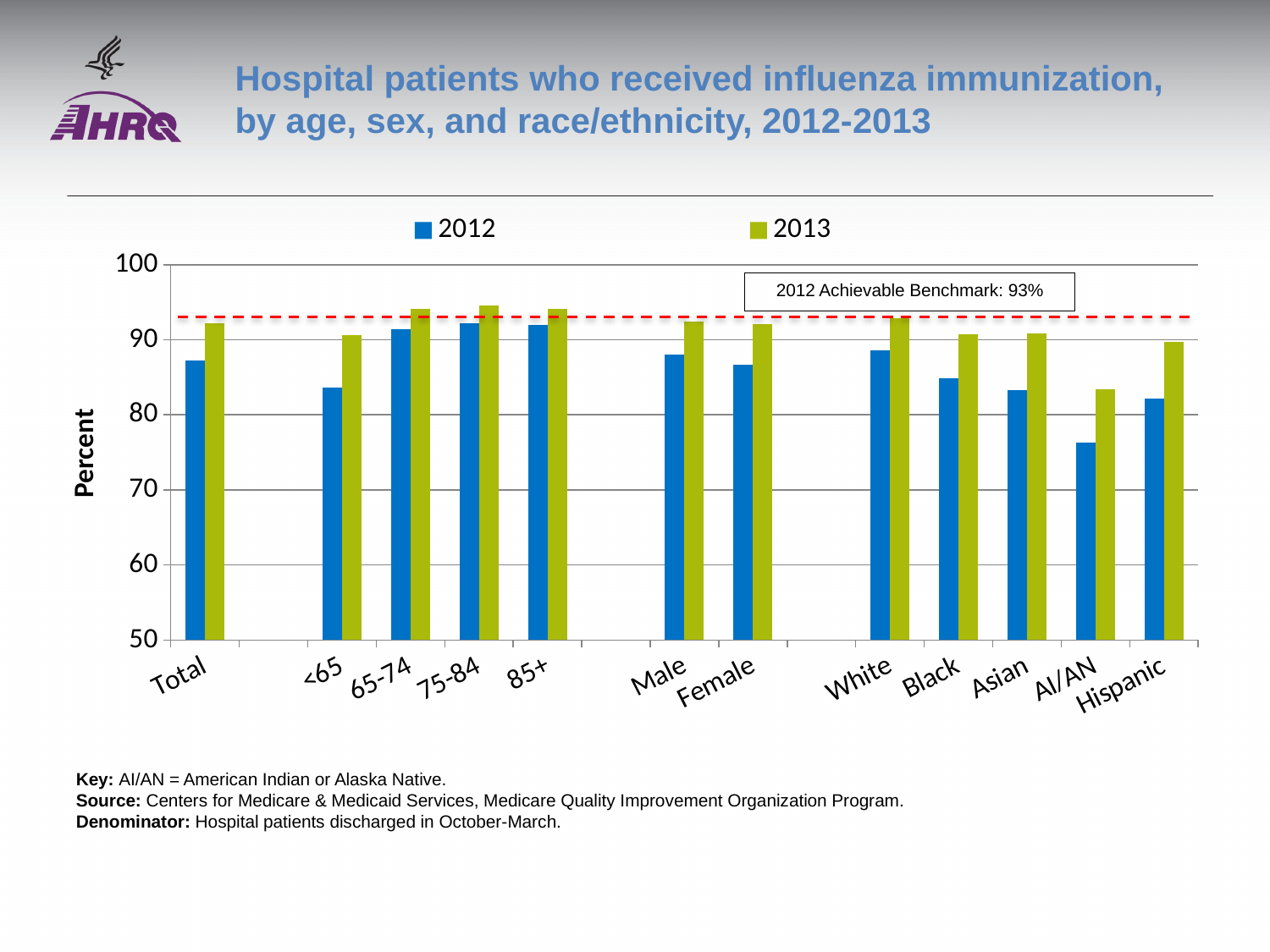
Is the 2012 value for Asian greater or less than 80? greater Which category has the lowest value for 2012? AI/AN How many series does the legend list? 2 What is the 2012 Achievable Benchmark shown on the chart? 93% Is the 2012 value for Female greater or less than 90? less Is the 2013 value for Total greater or less than 90? greater For the Total category, which year has the larger value, 2012 or 2013? 2013 Which category has the lowest value for 2013? AI/AN How many categories are shown along the x axis? 12 What kind of chart is shown on the slide? Bar chart Which is larger, the 2012 value for White or the 2012 value for Black? White